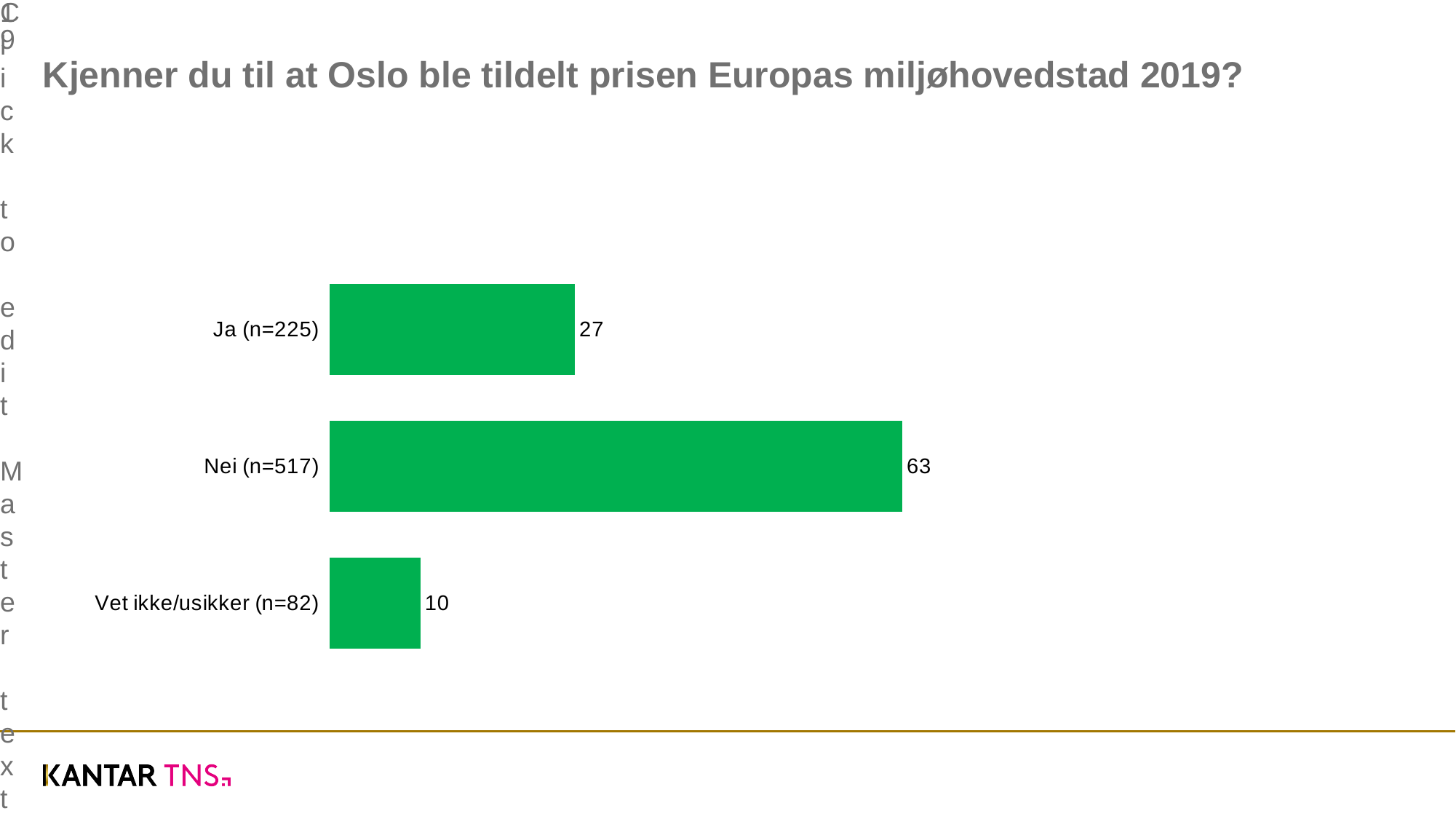
What is the value for Nei (n=517)? 63 What is the difference between the values for Ja (n=225) and Vet ikke/usikker (n=82)? 17 What is the title of the slide? Kjenner du til at Oslo ble tildelt prisen Europas miljøhovedstad 2019? What kind of chart is shown on the slide? bar chart Which category has the lowest value? Vet ikke/usikker (n=82) How many categories are shown in the chart? 3 What is the value for Ja (n=225)? 27 What is the difference between the values for Nei (n=517) and Ja (n=225)? 36 Which category has the highest value? Nei (n=517) What is the total of the three values shown in the chart? 100 Which is larger, the value for Ja (n=225) or the value for Vet ikke/usikker (n=82)? Ja (n=225) What is the value for Vet ikke/usikker (n=82)? 10